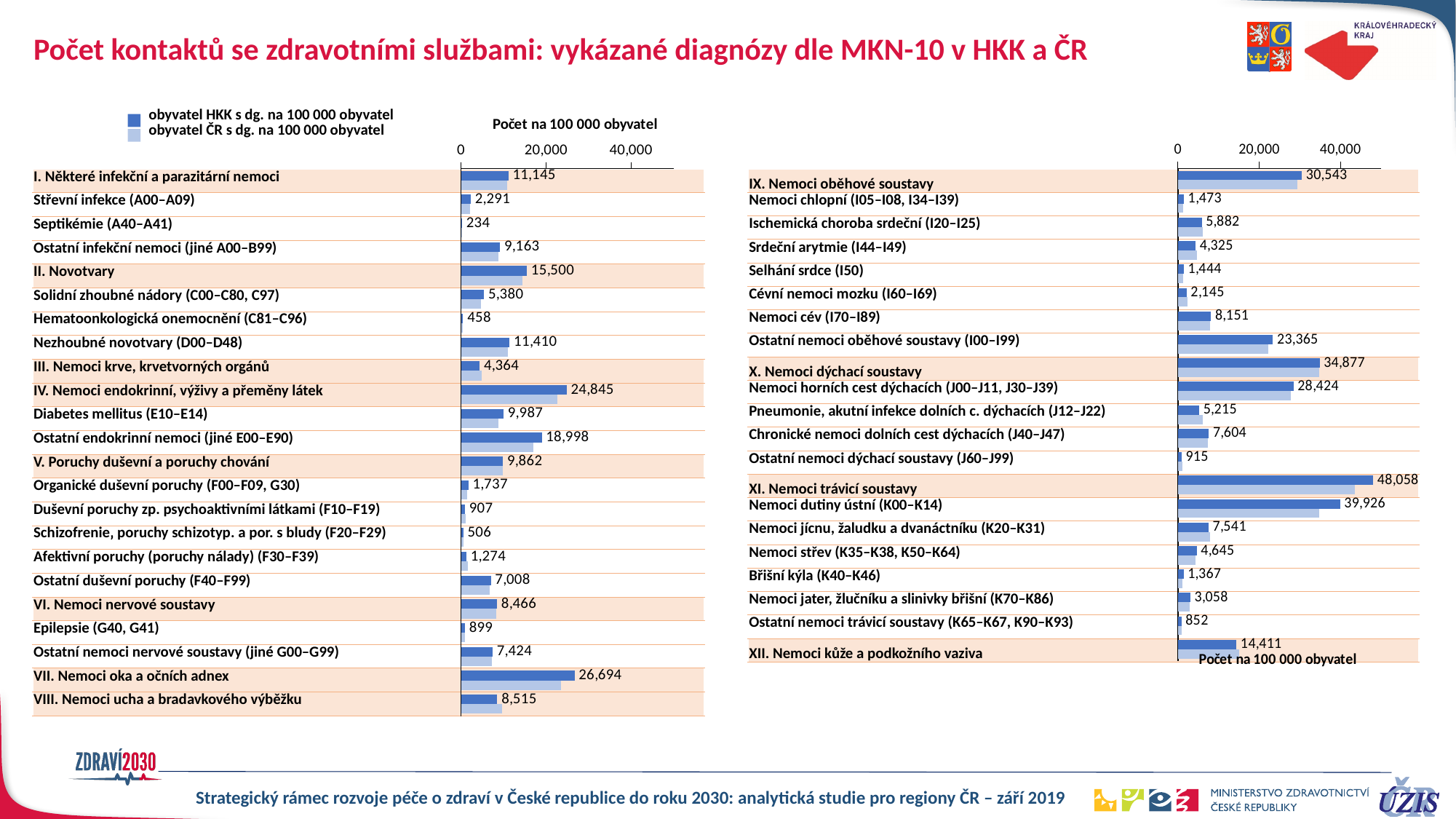
On the right chart, what is the difference between the HKK values for 'XI. Nemoci trávicí soustavy' and 'Nemoci dutiny ústní (K00–K14)'? 8,132 On the left chart, which has the larger HKK value: 'IV. Nemoci endokrinní, výživy a přeměny látek' or 'VII. Nemoci oka a očních adnex'? VII. Nemoci oka a očních adnex On the right chart, what is the HKK value labelled for 'IX. Nemoci oběhové soustavy'? 30,543 On the left chart, what is the HKK value labelled for 'Diabetes mellitus (E10–E14)'? 9,987 On the right chart, is the ČR value (light blue bar) for 'X. Nemoci dýchací soustavy' greater or less than 20,000? greater On the right chart, which category has the highest labelled HKK value? XI. Nemoci trávicí soustavy How many series does the legend list? 2 On the left chart, which category has the lowest labelled HKK value? Septikémie (A40–A41) What kind of chart is used on this slide? Bar chart On the left chart, which category has the highest labelled HKK value? VII. Nemoci oka a očních adnex On the left chart, what is the HKK value (dark blue bar) for 'II. Novotvary'? 15,500 On the right chart, which category has the lowest labelled HKK value? Ostatní nemoci trávicí soustavy (K65–K67, K90–K93)